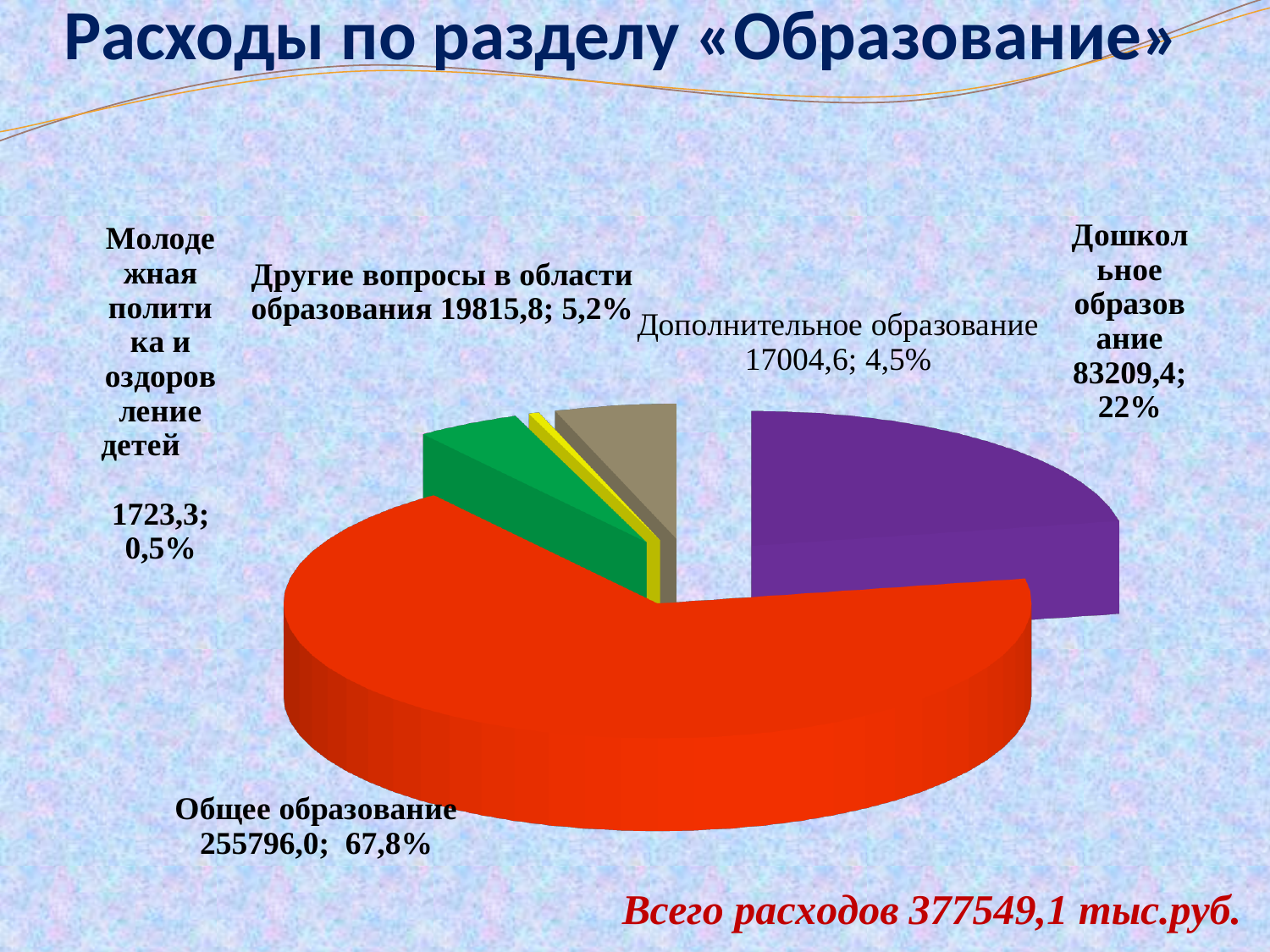
What is the value shown for «Молодежная политика и оздоровление детей»? 1723,3 What is the difference between the values for «Другие вопросы в области образования» and «Дополнительное образование»? 2811,2 What share of the pie does «Дошкольное образование» represent? 22% Which category has the largest share of the pie? Общее образование Which is larger, the value for «Дошкольное образование» or for «Дополнительное образование»? Дошкольное образование What is the value shown for «Дополнительное образование»? 17004,6 What kind of chart is shown on the slide? pie chart How many slices does the pie chart have? 5 Which category has the smallest share of the pie? Молодежная политика и оздоровление детей What percentage is shown for «Другие вопросы в области образования»? 5,2% What is the title of the chart on the slide? Расходы по разделу «Образование» What is the value shown for «Общее образование»? 255796,0